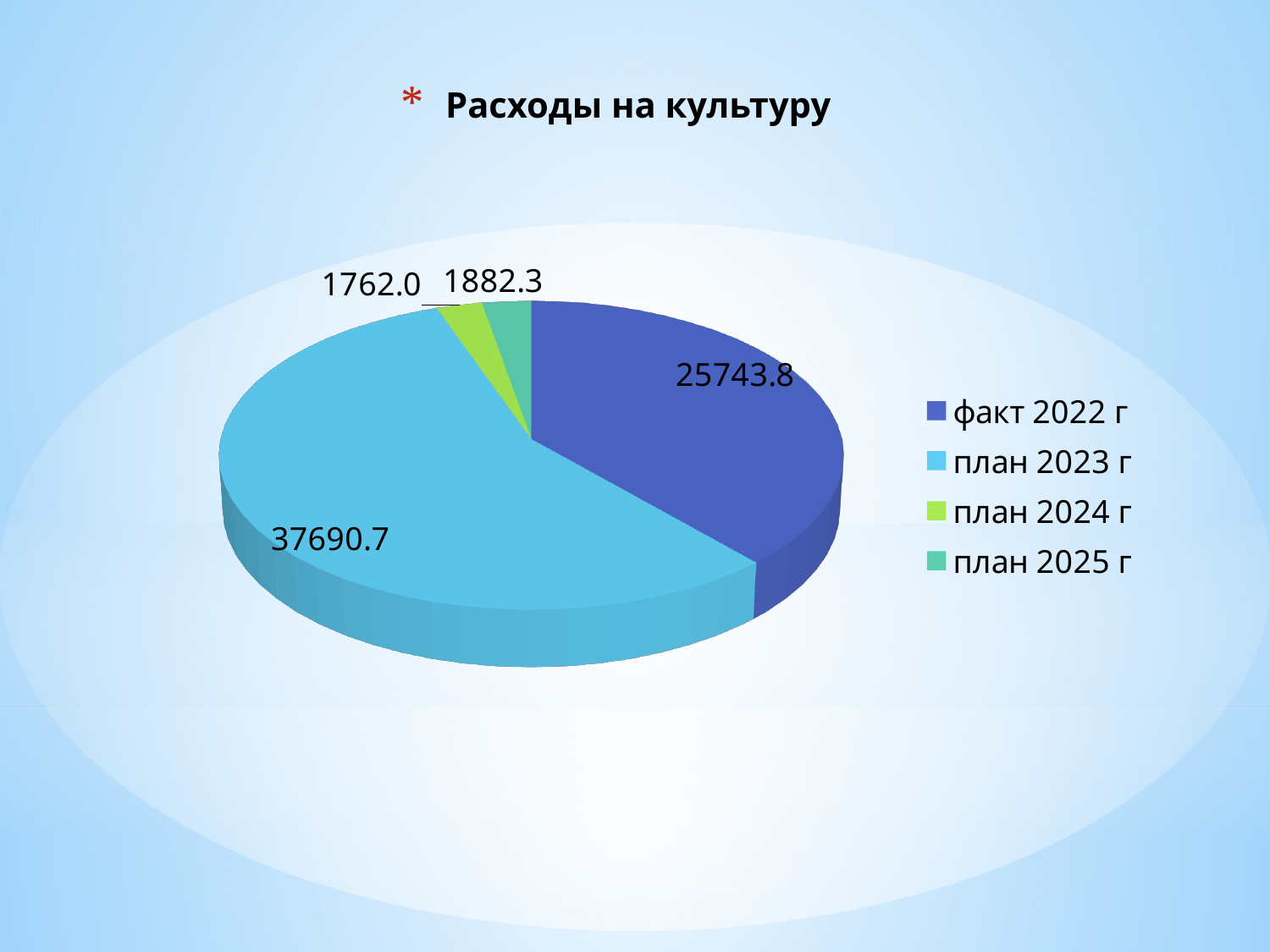
What kind of chart is shown on the slide? Pie chart Which category has the smallest slice of the pie? план 2024 г What is the value for план 2025 г? 1882.3 Which category has the largest slice of the pie? план 2023 г What is the value for план 2024 г? 1762.0 What colour is the slice for план 2024 г? Light green What is the difference between the values for план 2023 г and факт 2022 г? 11946.9 What is the value for факт 2022 г? 25743.8 What is the title of the chart? Расходы на культуру Which is larger, the value for план 2025 г or план 2024 г? план 2025 г What is the value for план 2023 г? 37690.7 How many categories does the legend list? 4